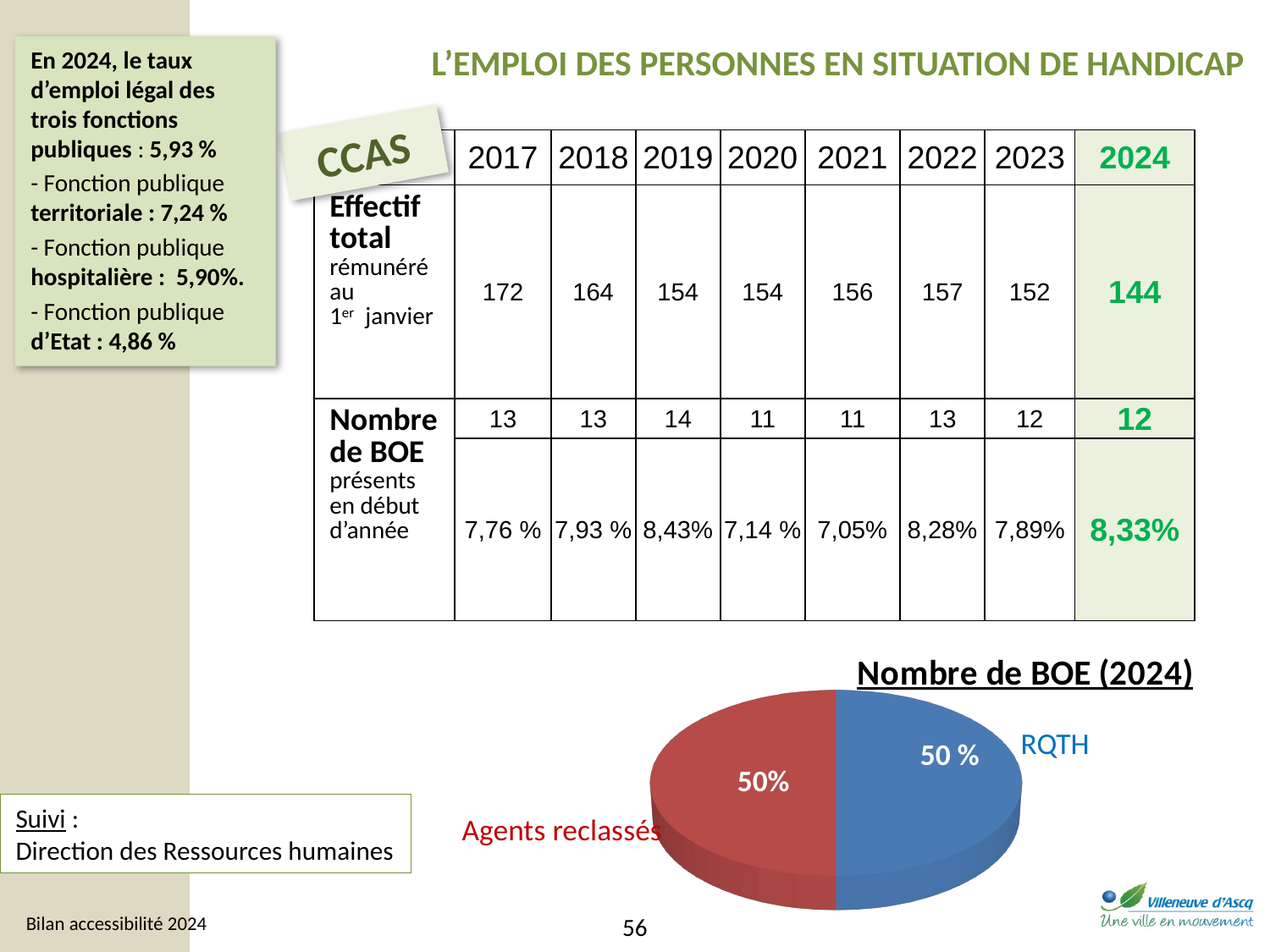
What is the title of the pie chart on the slide? Nombre de BOE (2024) In the 'Nombre de BOE (2024)' pie chart, what colour is the RQTH slice? blue In the 'Nombre de BOE (2024)' pie chart, what share is shown for Agents reclassés? 50% How many slices does the 'Nombre de BOE (2024)' pie chart have? 2 In the 'Nombre de BOE (2024)' pie chart, is the share for RQTH larger than, smaller than, or equal to the share for Agents reclassés? equal In the 'Nombre de BOE (2024)' pie chart, what share is shown for RQTH? 50 % What kind of chart is shown at the bottom of the slide under the title 'Nombre de BOE (2024)'? pie chart